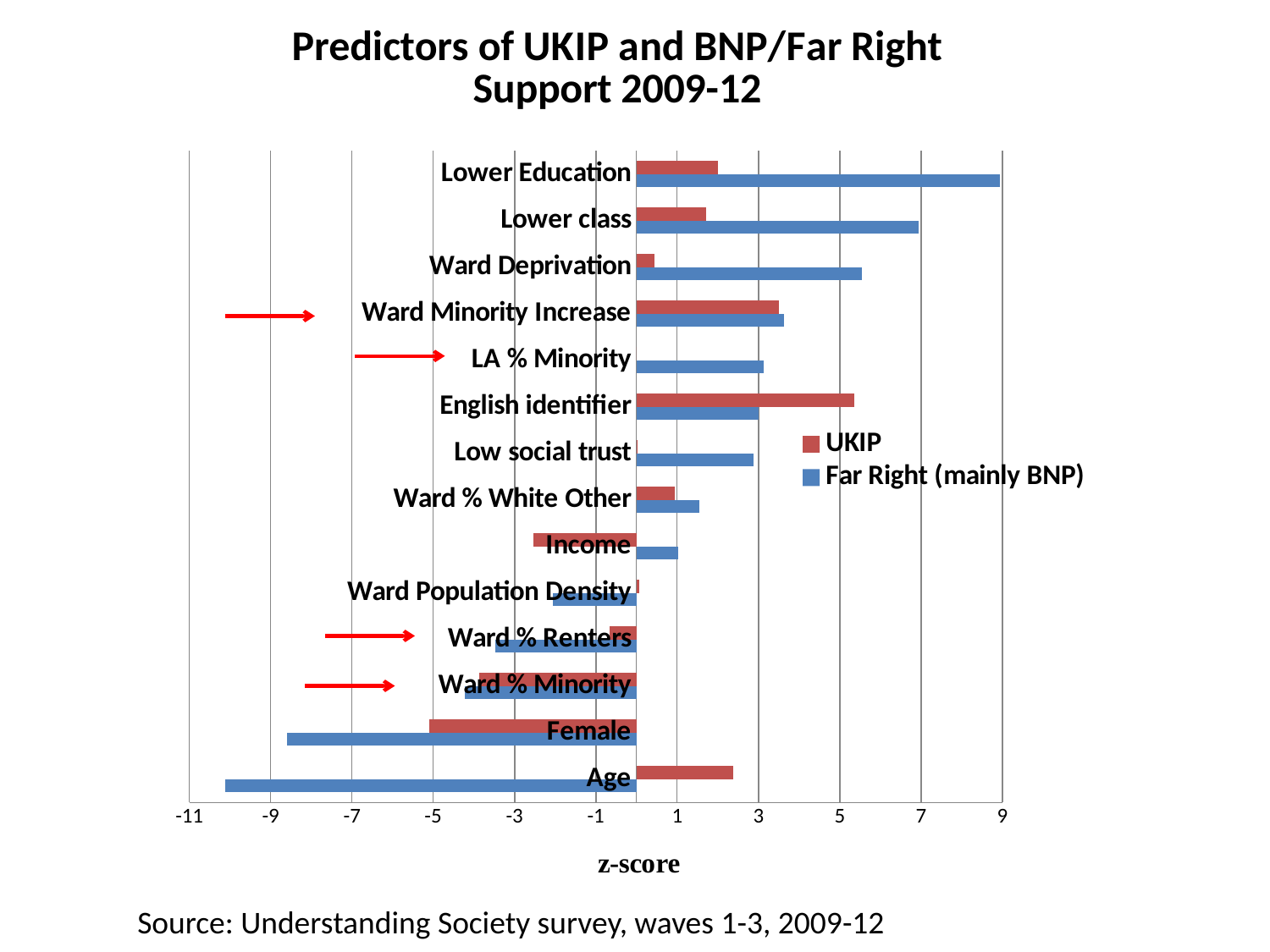
What kind of chart is shown on the slide? bar chart Which predictor has the lowest Far Right (mainly BNP) z-score? Age Is the Far Right (mainly BNP) value for Lower Education greater or less than 7? greater Which predictor has the highest Far Right (mainly BNP) z-score? Lower Education How many predictor categories are plotted on the chart? 14 What is the title of the horizontal axis? z-score Which predictor has the highest UKIP z-score? English identifier How many series does the legend list? 2 For English identifier, which series has the larger z-score, UKIP or Far Right (mainly BNP)? UKIP Is the UKIP value for English identifier greater or less than 3? greater Which predictor has the lowest UKIP z-score? Female Is the Far Right (mainly BNP) value for Age greater or less than -9? less